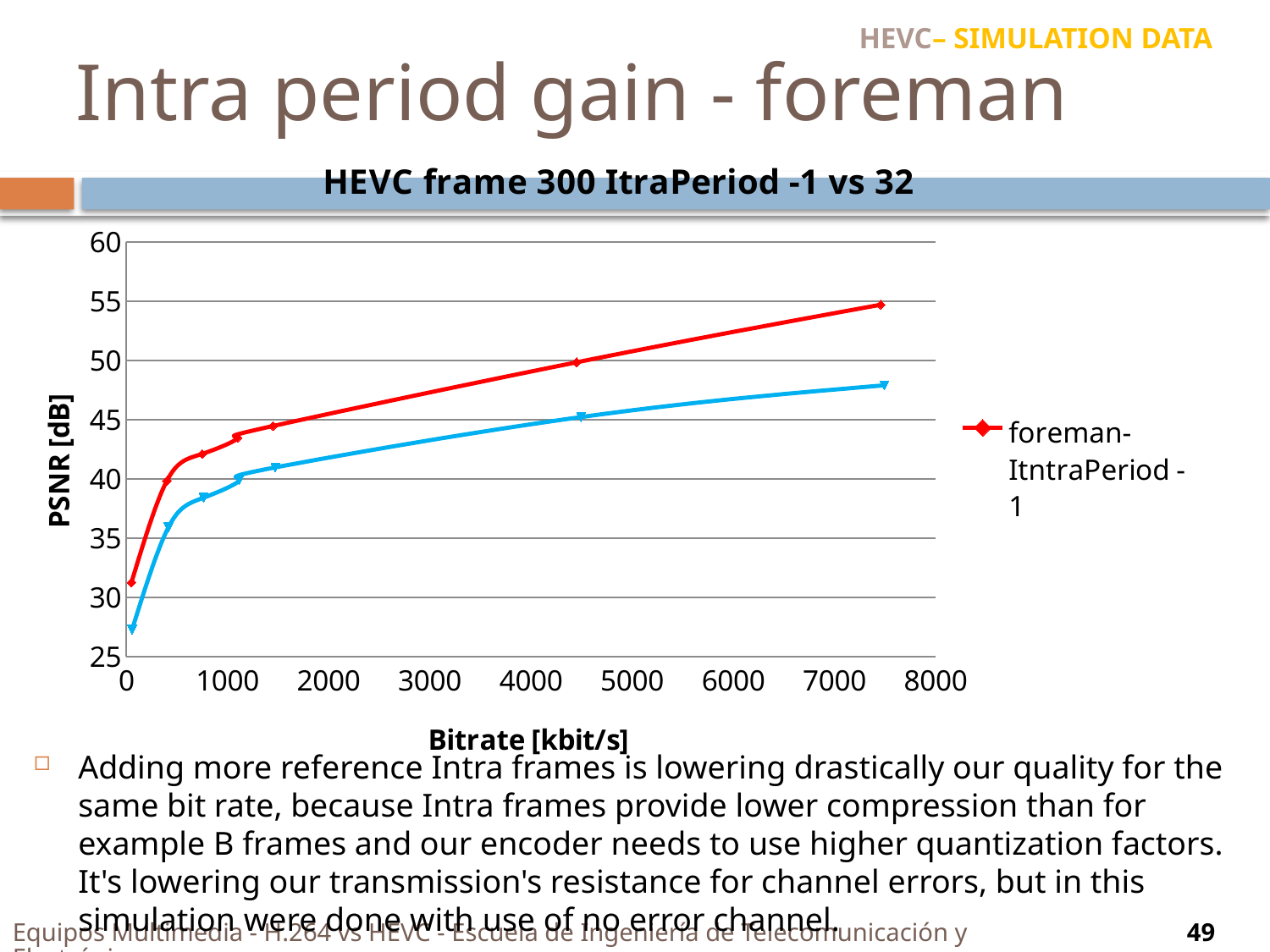
What is the title of the chart? HEVC frame 300 ItraPeriod -1 vs 32 Is the PSNR of the blue series at its lowest bitrate point greater or less than 30 dB? less Is the PSNR of the red foreman-ItntraPeriod -1 series at its lowest bitrate point greater or less than 30 dB? greater What is the label of the vertical axis of the chart? PSNR [dB] How many series does the chart's legend list? 1 At the highest bitrate point (around 7500 kbit/s), which series has the higher PSNR, the red foreman-ItntraPeriod -1 series or the blue series? the red foreman-ItntraPeriod -1 series Does the PSNR of the blue series rise or fall as bitrate increases? rise Does the PSNR of the red foreman-ItntraPeriod -1 series rise or fall as bitrate increases? rise Is the PSNR of the red foreman-ItntraPeriod -1 series at its highest bitrate point (around 7500 kbit/s) greater or less than 50 dB? greater What kind of chart is shown on the slide? line chart